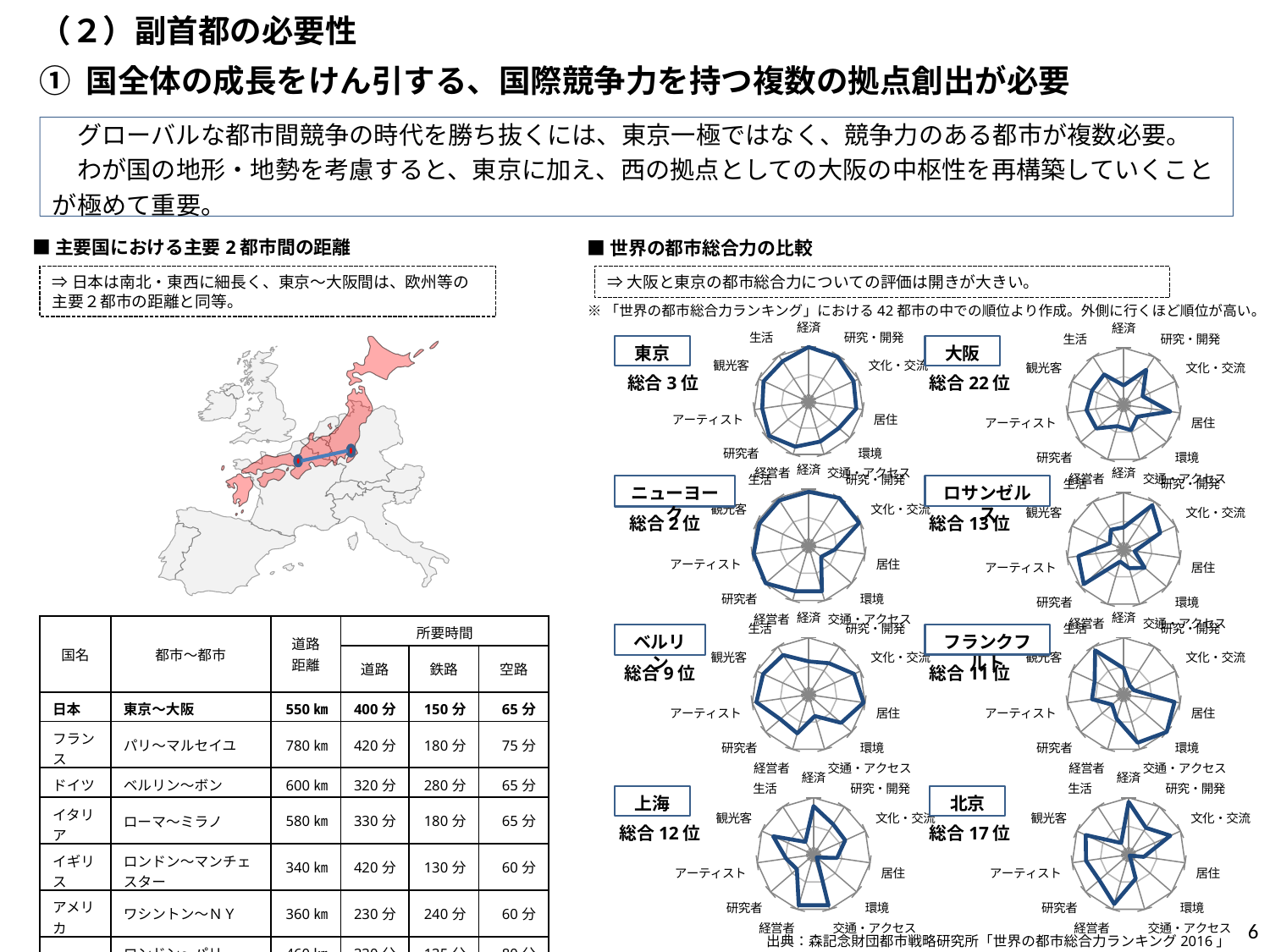
According to the note above the radar charts, does a point further from the centre indicate a higher or lower rank? Higher rank Which city among the eight radar charts has the worst (highest-numbered) overall rank? 大阪 What overall rank (総合) is printed next to the 東京 radar chart? 総合 3 位 What overall rank (総合) is printed next to the 北京 radar chart? 総合 17 位 Which city among the eight radar charts has the best (lowest-numbered) overall rank? ニューヨーク On the 経済 axis, which radar chart extends further outward, 東京 or 大阪? 東京 How many radar charts are shown under the heading 世界の都市総合力の比較? 8 What overall rank (総合) is printed next to the 大阪 radar chart? 総合 22 位 Which city's radar chart is labelled 総合 12 位? 上海 What overall rank (総合) is printed next to the ニューヨーク radar chart? 総合 2 位 What kind of chart is used to compare the cities' overall strength on the right side of the slide? Radar chart How many axes (evaluation categories) does each radar chart have? 11